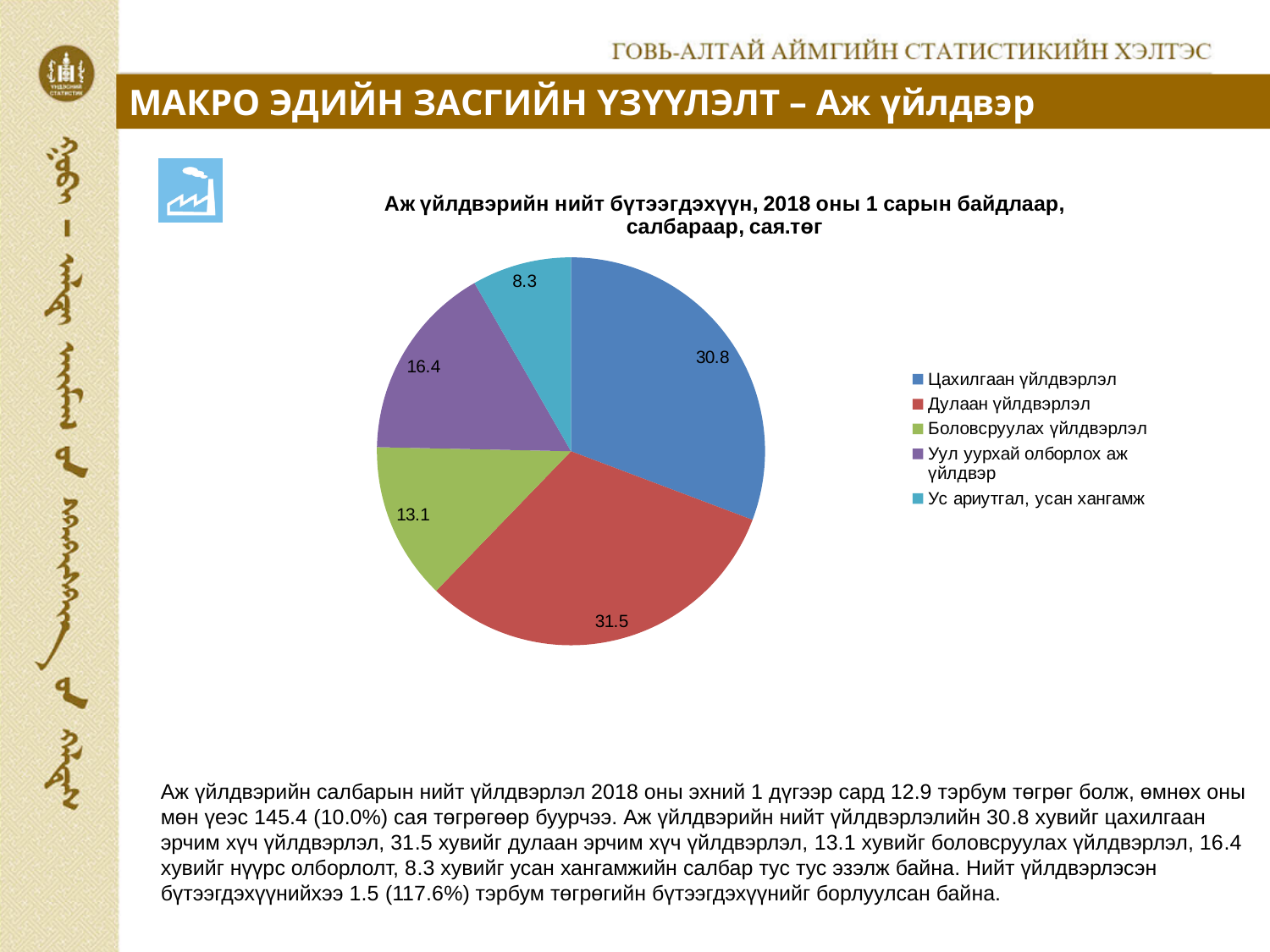
What is the value shown for Цахилгаан үйлдвэрлэл? 30.8 What is the value shown for Дулаан үйлдвэрлэл? 31.5 Which is larger, the value for Уул уурхай олборлох аж үйлдвэр or the value for Боловсруулах үйлдвэрлэл? Уул уурхай олборлох аж үйлдвэр What colour is the slice for Боловсруулах үйлдвэрлэл? Green What is the value shown for Боловсруулах үйлдвэрлэл? 13.1 Which category has the largest slice of the pie? Дулаан үйлдвэрлэл How many categories does the pie chart have? 5 Which category has the smallest slice of the pie? Ус ариутгал, усан хангамж What is the value shown for Уул уурхай олборлох аж үйлдвэр? 16.4 What is the value shown for Ус ариутгал, усан хангамж? 8.3 What kind of chart is shown on the slide? Pie chart What is the difference between the values for Дулаан үйлдвэрлэл and Цахилгаан үйлдвэрлэл? 0.7